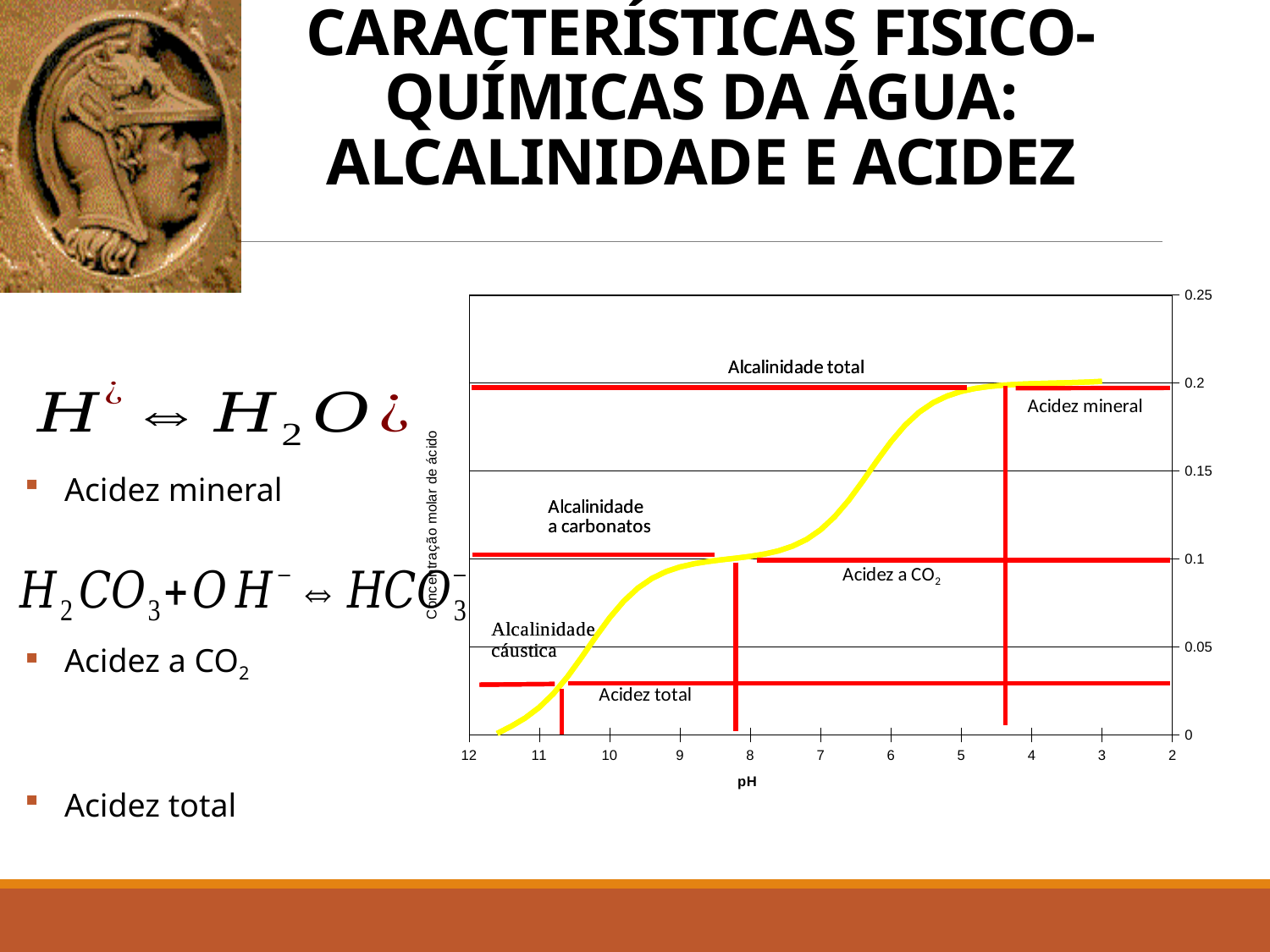
What kind of chart is shown on the slide? line chart Is the acid concentration at pH 9 greater or less than 0.05? greater What is the label of the y axis of the chart? Concentração molar de ácido What is the highest value shown on the y axis of the chart? 0.25 Is the acid concentration higher at pH 10 or at pH 6? pH 6 Is the acid concentration at pH 10 greater or less than 0.1? less What is the label of the x axis of the chart? pH Is the acid concentration higher at pH 11 or at pH 3? pH 3 Is the acid concentration at pH 5 greater or less than 0.15? greater Do the values of the curve rise or fall from left to right along the pH axis? rise